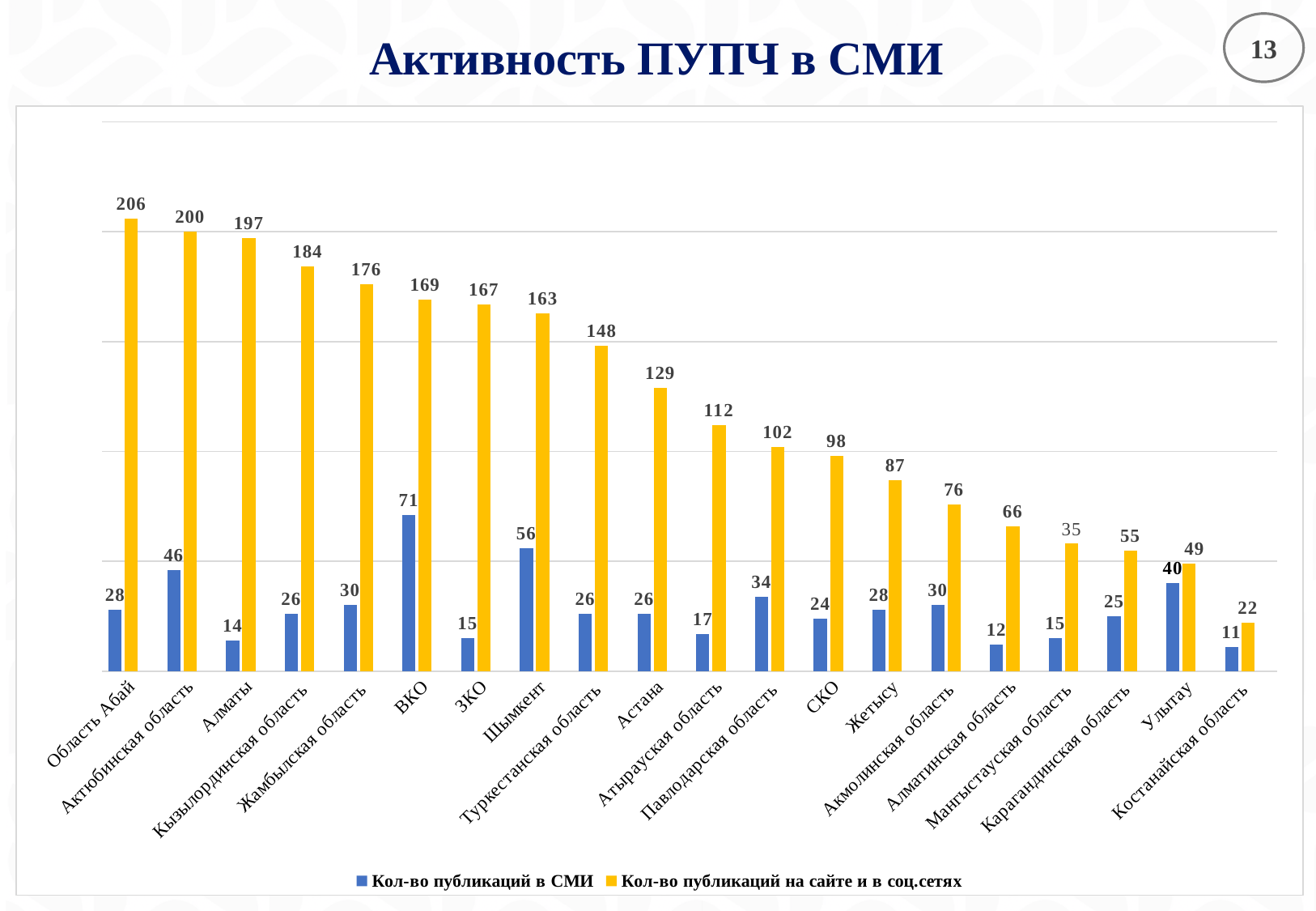
Which category has the highest value for 'Кол-во публикаций на сайте и в соц.сетях'? Область Абай What is the value of 'Кол-во публикаций в СМИ' for ВКО? 71 Which category has the lowest value for 'Кол-во публикаций в СМИ'? Костанайская область How many series does the legend list? 2 What is the difference between 'Кол-во публикаций на сайте и в соц.сетях' and 'Кол-во публикаций в СМИ' for Шымкент? 107 Which is larger: 'Кол-во публикаций в СМИ' for Актюбинская область or for Шымкент? Шымкент What is the title of the slide? Активность ПУПЧ в СМИ Do the values of 'Кол-во публикаций на сайте и в соц.сетях' generally rise or fall from left to right along the x axis? fall What is the value of 'Кол-во публикаций на сайте и в соц.сетях' for Область Абай? 206 What type of chart is shown on the slide? bar chart How many categories (regions/cities) are shown on the x axis? 20 What is the value of 'Кол-во публикаций на сайте и в соц.сетях' for Астана? 129